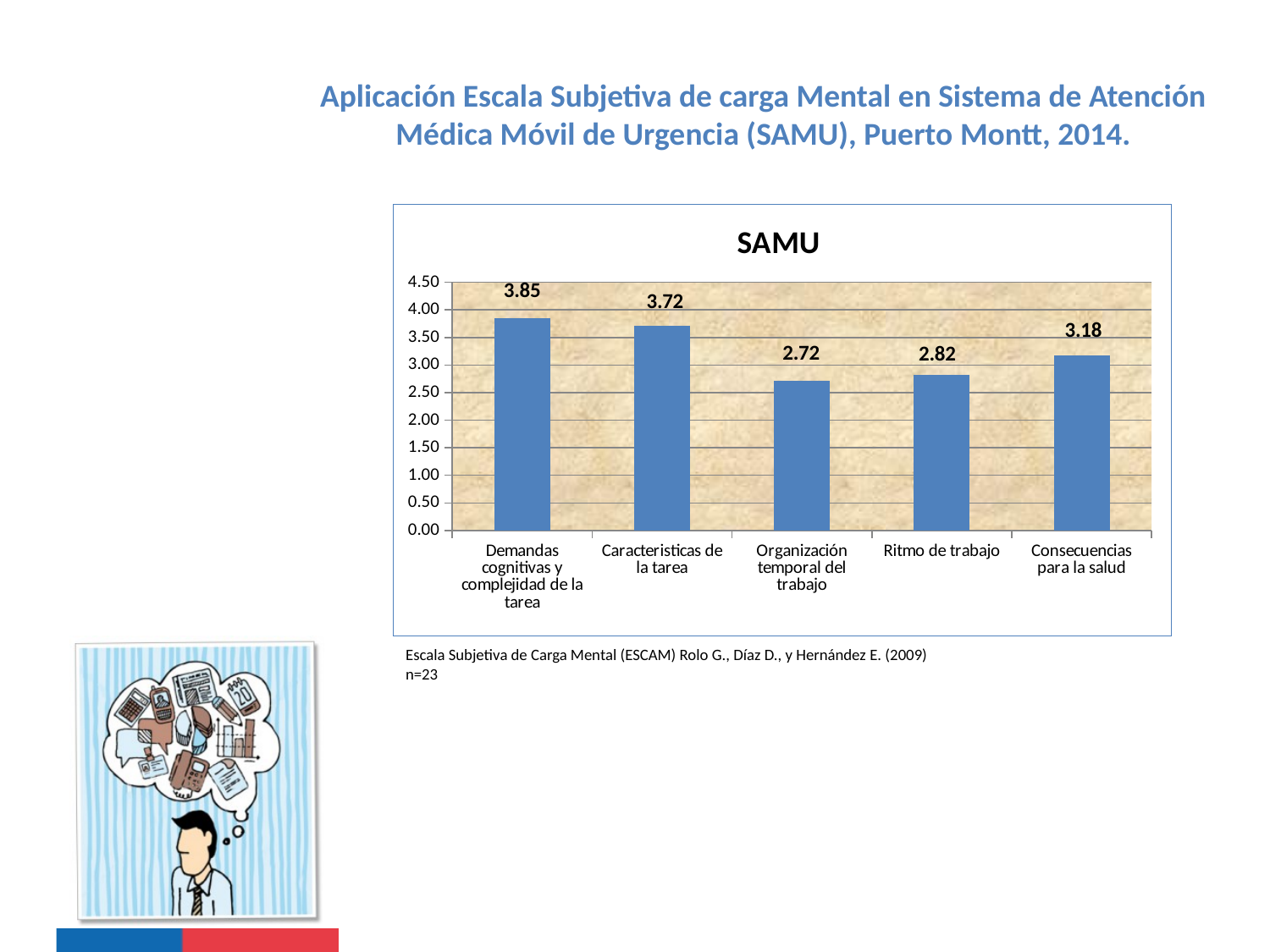
Which category has the lowest value? Organización temporal del trabajo What is the title of the chart? SAMU What is the difference between the values for Demandas cognitivas y complejidad de la tarea and Caracteristicas de la tarea? 0.13 What is the value for Demandas cognitivas y complejidad de la tarea? 3.85 How many categories are shown on the x axis? 5 What is the difference between the values for Consecuencias para la salud and Ritmo de trabajo? 0.36 Is the value for Caracteristicas de la tarea greater or less than 3.50? greater Which is larger, the value for Ritmo de trabajo or the value for Organización temporal del trabajo? Ritmo de trabajo Which category has the highest value? Demandas cognitivas y complejidad de la tarea What kind of chart is shown? bar chart What is the value for Organización temporal del trabajo? 2.72 What is the value for Consecuencias para la salud? 3.18